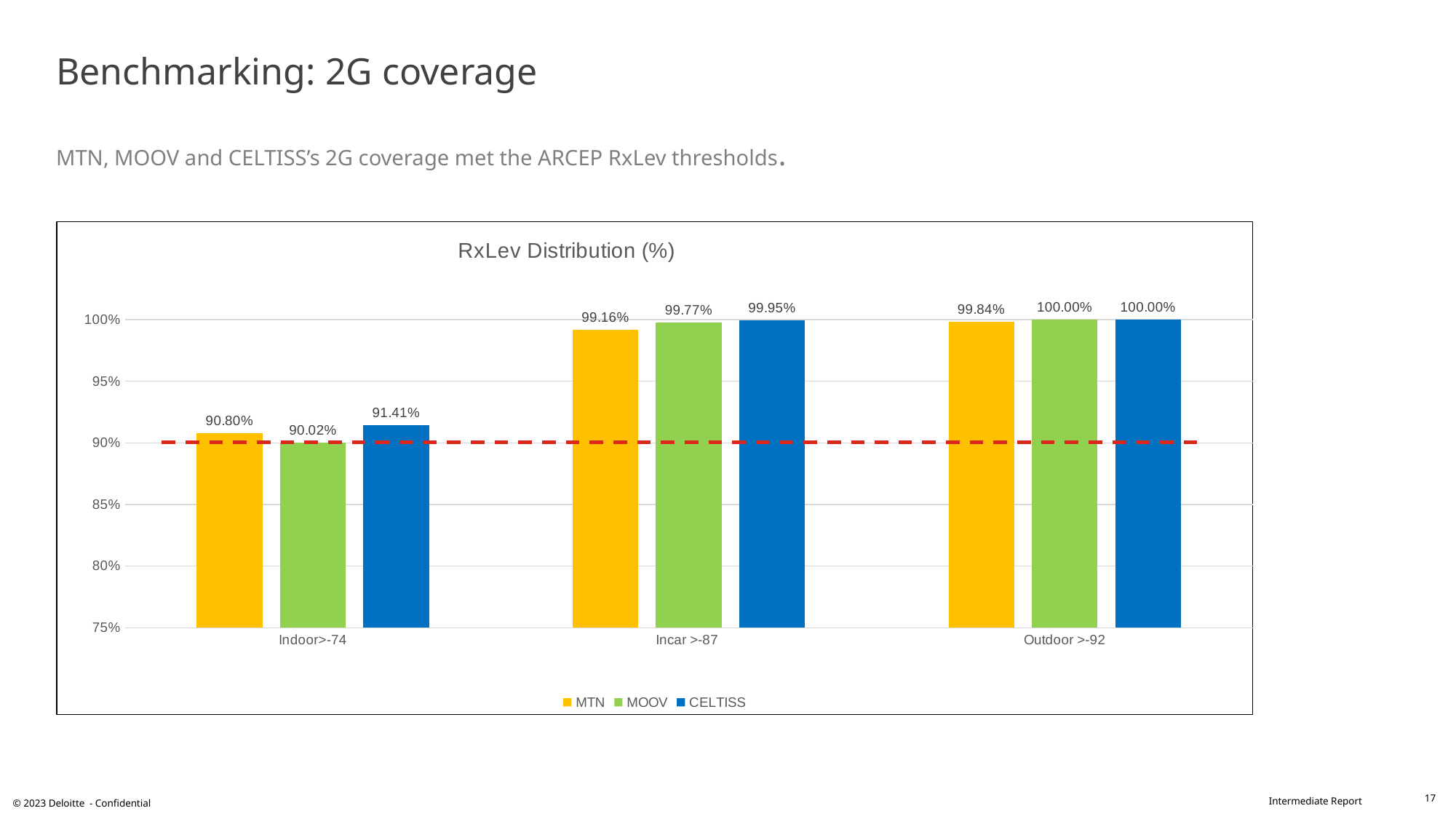
What is the MTN value for Indoor>-74? 90.80% How many series does the legend list? 3 What is the title of the chart? RxLev Distribution (%) What kind of chart is shown on the slide? bar chart Which operator has the highest value for Indoor>-74? CELTISS How many categories are shown on the x axis? 3 What is the MOOV value for Incar >-87? 99.77% Which is larger for Incar >-87: the MTN value or the CELTISS value? CELTISS Is the MOOV value for Indoor>-74 greater or less than 95%? less Which operator has the lowest value for Indoor>-74? MOOV What is the difference between the CELTISS and MOOV values for Indoor>-74? 1.39% What is the CELTISS value for Outdoor >-92? 100.00%